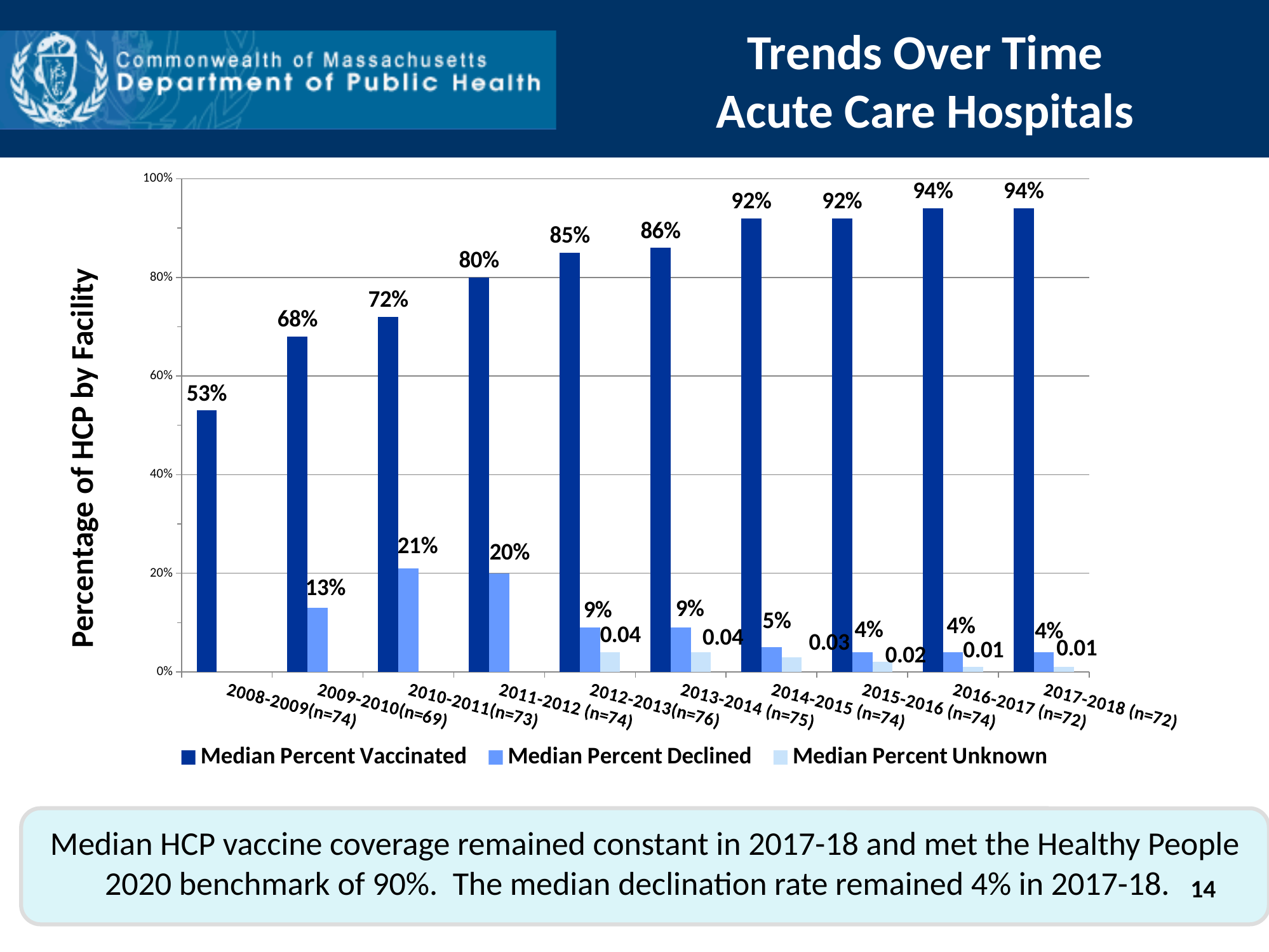
How many series does the legend list? 3 Which season has the lowest Median Percent Vaccinated? 2008-2009 (n=74) What is the Median Percent Declined for 2010-2011 (n=73)? 21% What kind of chart is shown on the slide? Bar chart By how many percentage points did the Median Percent Vaccinated increase from 2008-2009 to 2017-2018? 41 percentage points What is the Median Percent Unknown value shown for 2015-2016 (n=74)? 0.02 Which season has a higher Median Percent Vaccinated, 2011-2012 or 2012-2013? 2012-2013 Does the Median Percent Vaccinated generally rise or fall from 2008-2009 to 2017-2018? Rise How many seasons (categories) are shown on the x axis? 10 What is the title of the y axis? Percentage of HCP by Facility What is the Median Percent Vaccinated for 2008-2009 (n=74)? 53% Which season has the highest Median Percent Declined? 2010-2011 (n=73)